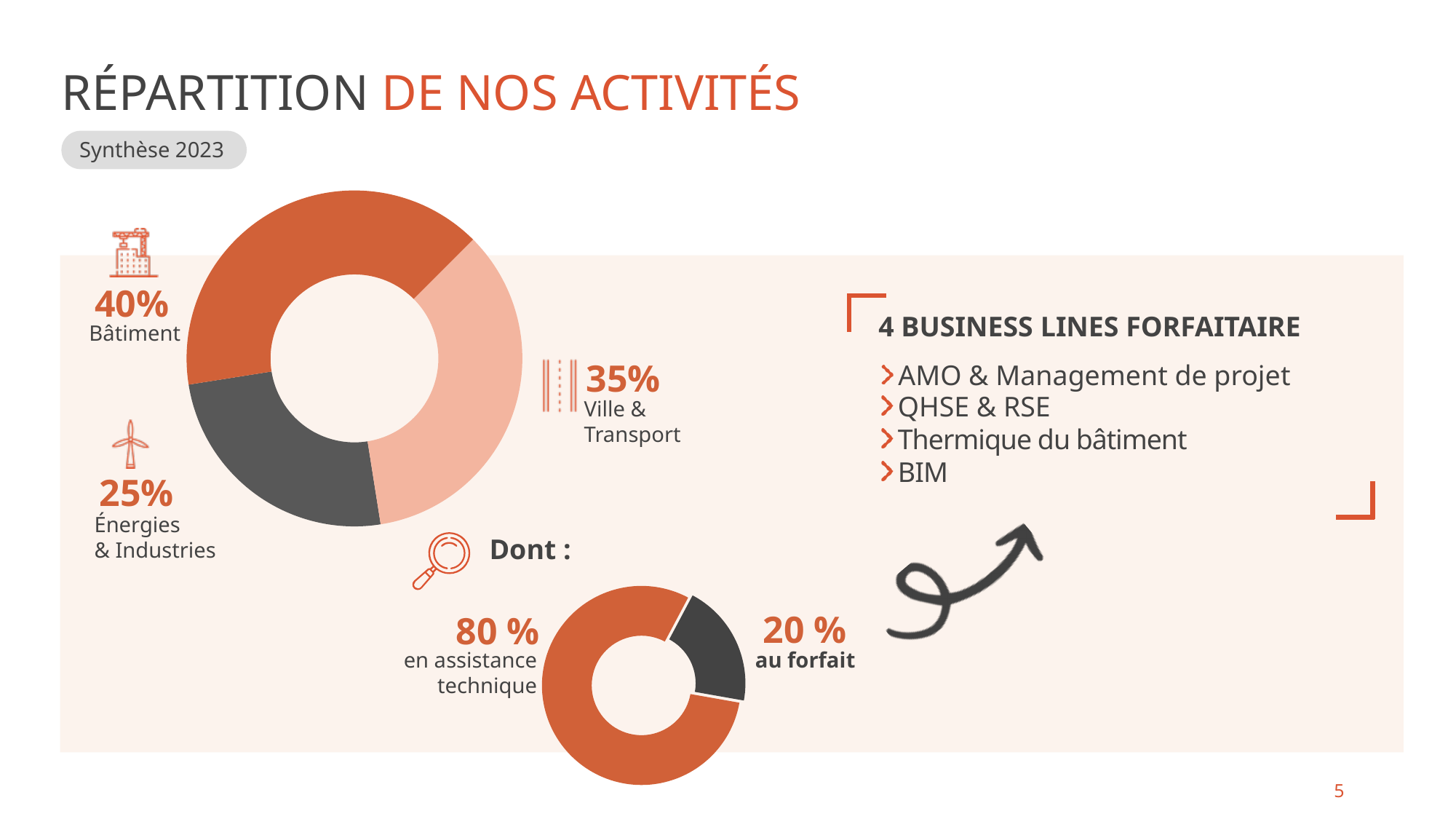
What type of chart is the large chart on the left? Donut chart In the small donut chart at the bottom, what share is 'en assistance technique'? 80 % In the large donut chart on the left, what share is Énergies & Industries? 25% In the large donut chart on the left, which is larger: Ville & Transport or Énergies & Industries? Ville & Transport How many segments does the large donut chart on the left have? 3 In the large donut chart on the left, what share is Bâtiment? 40% In the large donut chart on the left, what is the difference in percentage points between Bâtiment and Énergies & Industries? 15 In the large donut chart on the left, what share is Ville & Transport? 35% In the small donut chart at the bottom, what share is 'au forfait'? 20 % In the small donut chart at the bottom, what is the difference in percentage points between 'en assistance technique' and 'au forfait'? 60 In the large donut chart on the left, which activity has the smallest share? Énergies & Industries In the large donut chart on the left, which activity has the largest share? Bâtiment